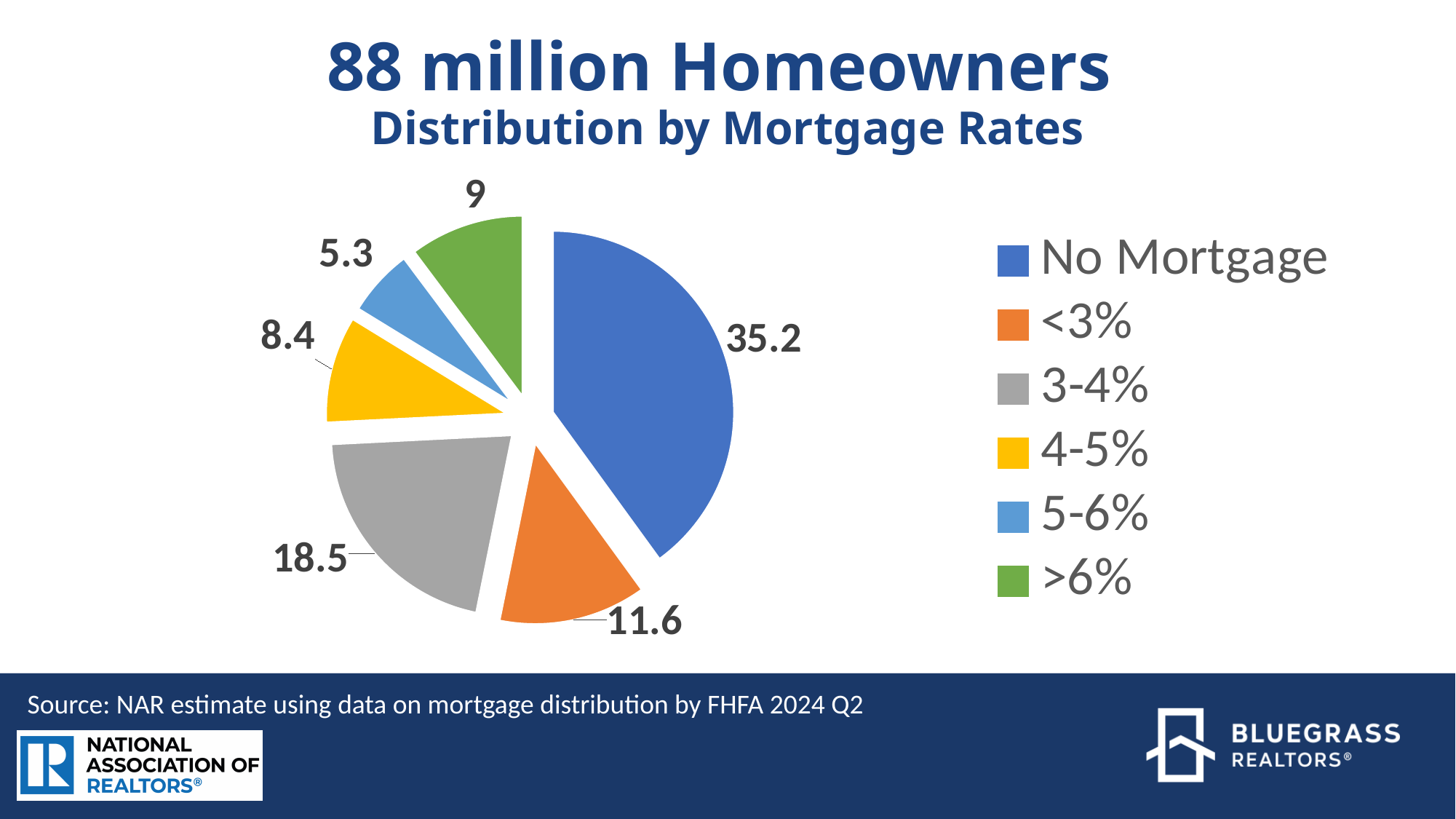
How many categories does the pie chart have? 6 What share of the pie does the No Mortgage slice represent? 40% What is the difference between the No Mortgage value and the 3-4% value? 16.7 What is the value for the No Mortgage slice? 35.2 Which category has the smallest slice of the pie? 5-6% What is the value for the >6% slice? 9 Which category has the largest slice of the pie? No Mortgage What colour is the 4-5% slice in the pie chart? yellow What type of chart is shown on the slide? pie chart Which is larger, the <3% slice or the 4-5% slice? <3% What is the value for the 3-4% slice? 18.5 What is the value for the 5-6% slice? 5.3